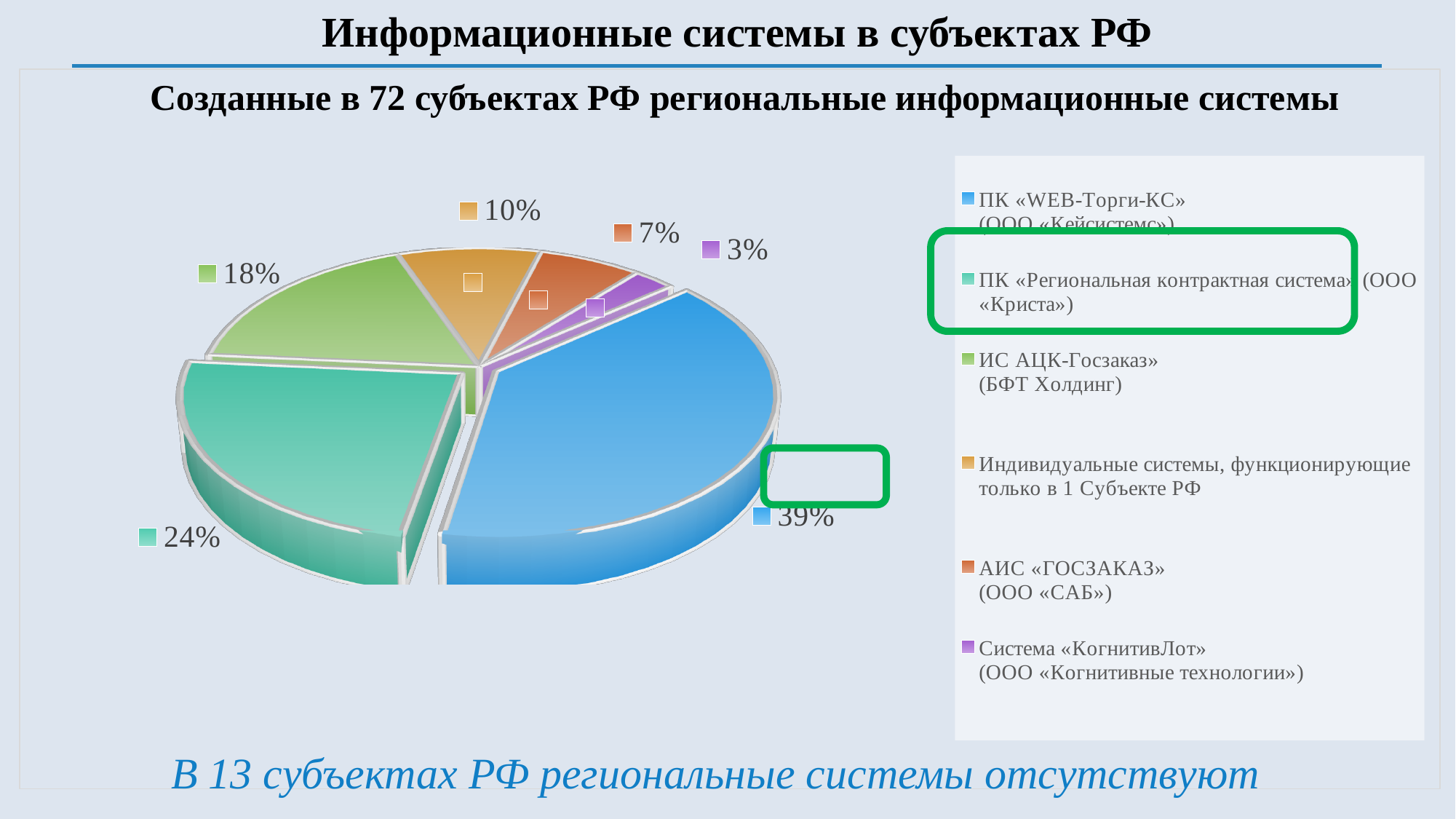
What share of the pie does ПК «Региональная контрактная система» (ООО «Криста») have? 24% What share of the pie does ПК «WEB-Торги-КС» (ООО «Кейсистемс») have? 39% What kind of chart is shown on the slide? pie chart What share of the pie does ИС АЦК-Госзаказ» (БФТ Холдинг) have? 18% What share of the pie is labelled for Индивидуальные системы, функционирующие только в 1 Субъекте РФ? 10% What share of the pie does Система «КогнитивЛот» (ООО «Когнитивные технологии») have? 3% What share of the pie does АИС «ГОСЗАКАЗ» (ООО «САБ») have? 7% Which slice is larger: ИС АЦК-Госзаказ» or АИС «ГОСЗАКАЗ»? ИС АЦК-Госзаказ» Which system has the largest slice of the pie? ПК «WEB-Торги-КС» (ООО «Кейсистемс») Which system has the smallest slice of the pie? Система «КогнитивЛот» (ООО «Когнитивные технологии») What is the difference in percentage points between the ПК «WEB-Торги-КС» slice and the ПК «Региональная контрактная система» slice? 15 How many slices does the pie chart have? 6